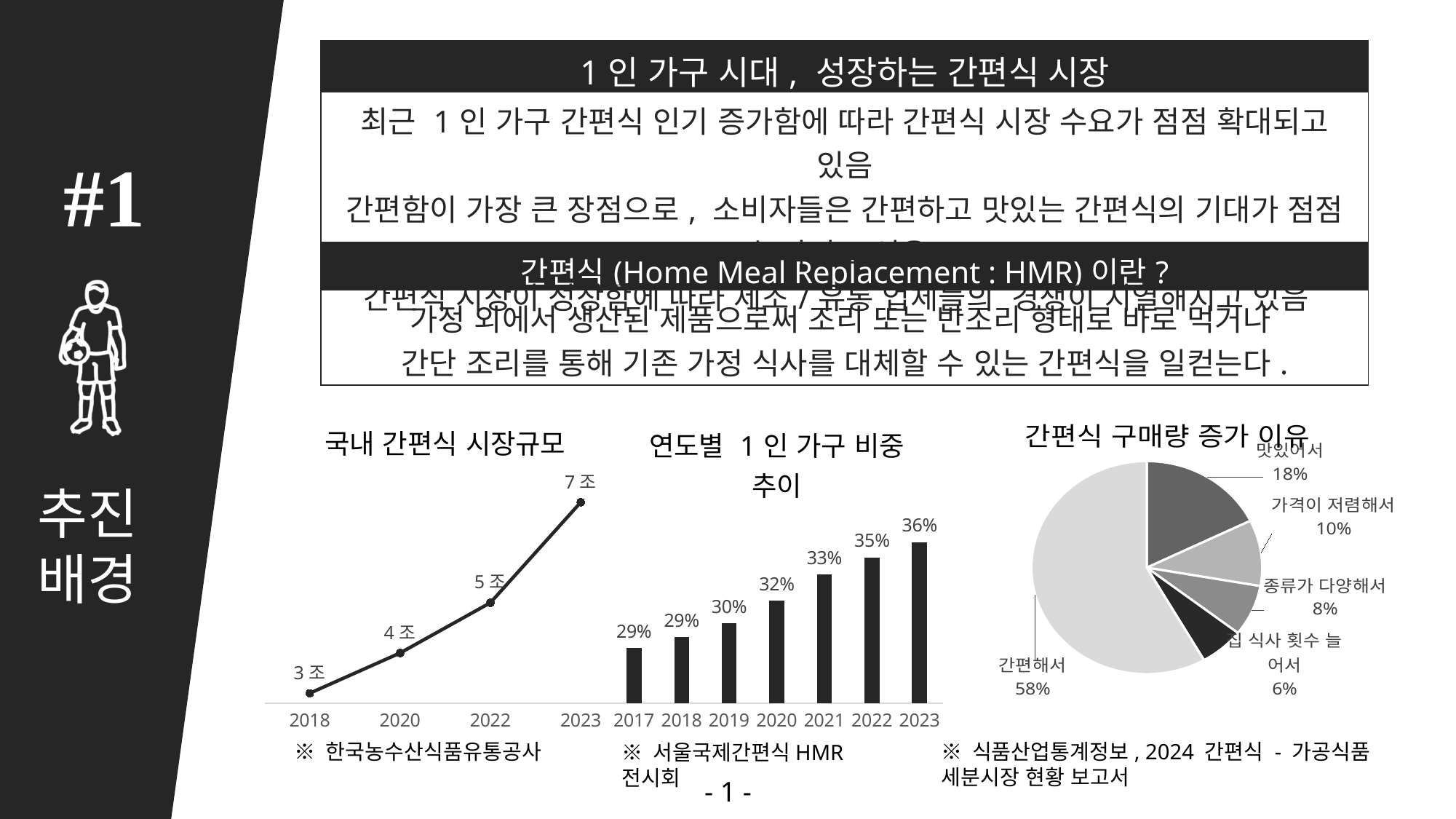
In the '연도별 1인 가구 비중 추이' chart, what kind of chart is shown? bar chart In the '연도별 1인 가구 비중 추이' chart, which year has the highest value? 2023 In the '국내 간편식 시장규모' chart, what kind of chart is shown? line chart In the '간편식 구매량 증가 이유' pie chart, which is larger, '맛있어서' or '가격이 저렴해서'? 맛있어서 In the '연도별 1인 가구 비중 추이' chart, what is the value for 2020? 32% In the '국내 간편식 시장규모' chart, do the values rise or fall from 2018 to 2023? rise In the '국내 간편식 시장규모' chart, what is the value for 2018? 3 조 In the '국내 간편식 시장규모' chart, how many data points are plotted? 4 In the '연도별 1인 가구 비중 추이' chart, what is the difference between the 2023 value and the 2017 value? 7% In the '국내 간편식 시장규모' chart, what is the value for 2023? 7 조 In the '간편식 구매량 증가 이유' pie chart, what share does '간편해서' have? 58% In the '연도별 1인 가구 비중 추이' chart, how many years are shown on the x axis? 7